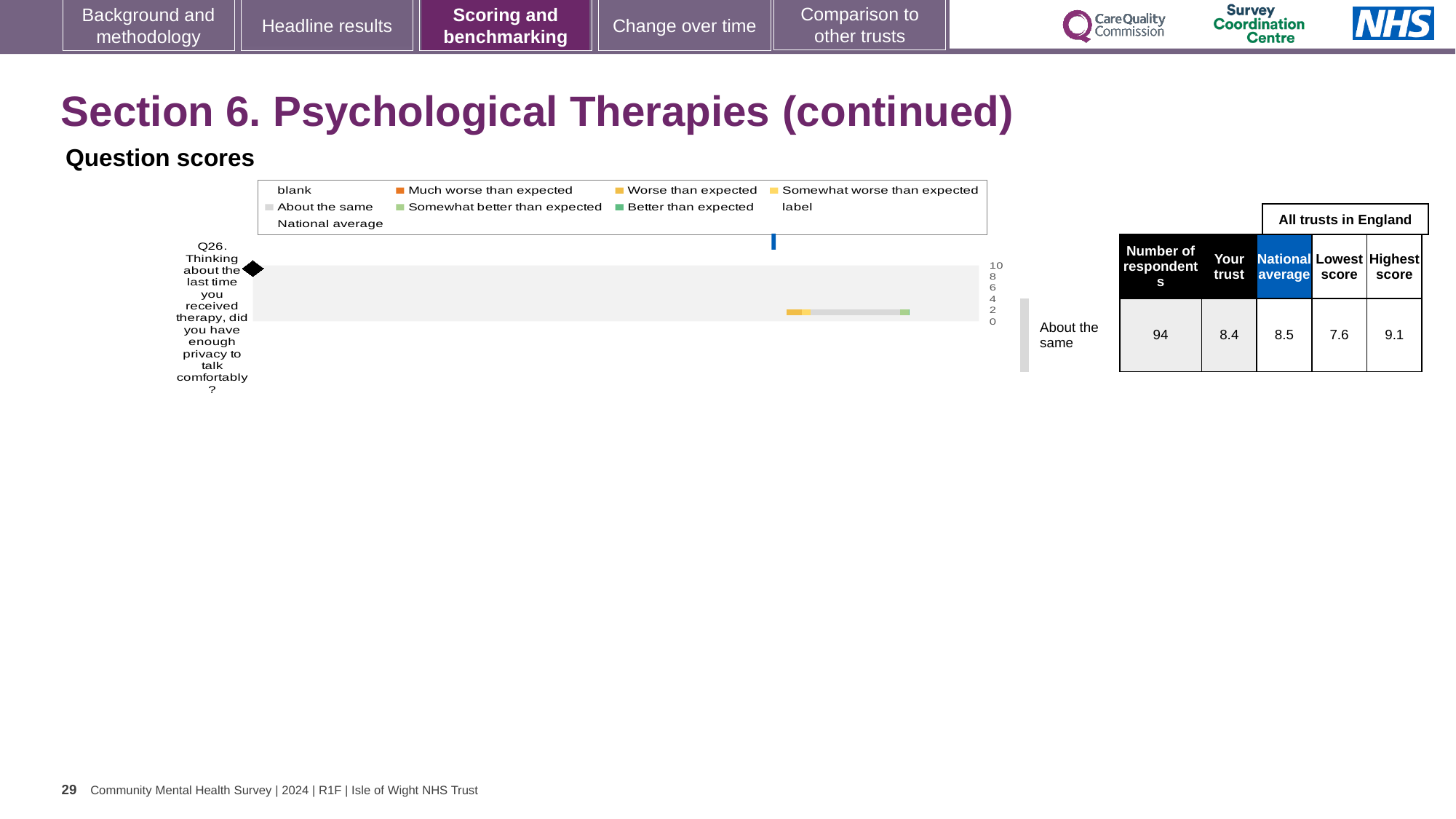
Which is larger for Q26, the 'Your trust' score or the national average? National average What benchmark category is the trust's Q26 score assigned to? About the same How many entries does the legend of the Question scores chart list? 9 What is the national average score for Q26 shown next to the chart? 8.5 What is the highest score among all trusts in England for Q26? 9.1 What is the lowest score among all trusts in England for Q26? 7.6 How many respondents answered Q26? 94 What is the 'Your trust' score for Q26 shown next to the chart? 8.4 What kind of chart is shown under 'Question scores'? bar chart Which question is plotted in the Question scores chart? Q26. Thinking about the last time you received therapy, did you have enough privacy to talk comfortably? What is the difference between the highest and lowest scores for Q26 across all trusts in England? 1.5 How many questions (categories) are plotted in the Question scores chart? 1